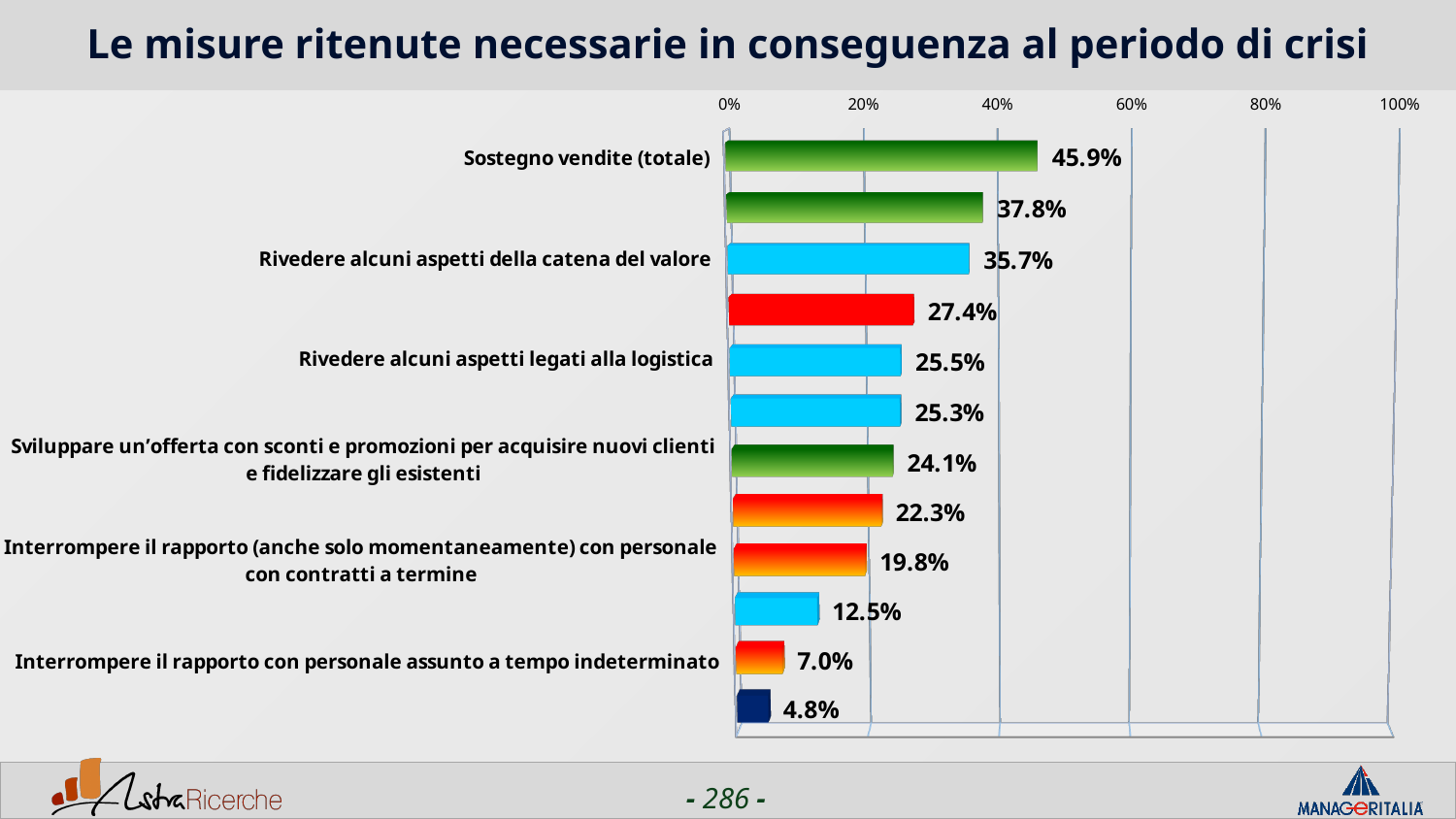
What is the value for "Rivedere alcuni aspetti della catena del valore"? 35.7% What is the value for "Rivedere alcuni aspetti legati alla logistica"? 25.5% What is the difference between the values for "Sostegno vendite (totale)" and "Rivedere alcuni aspetti della catena del valore"? 10.2 percentage points What is the title of the slide? Le misure ritenute necessarie in conseguenza al periodo di crisi How many bars are plotted in the chart? 12 What type of chart is shown on the slide? bar chart What is the smallest value shown in the chart? 4.8% Which is larger: the value for "Rivedere alcuni aspetti legati alla logistica" or the value for "Interrompere il rapporto con personale assunto a tempo indeterminato"? Rivedere alcuni aspetti legati alla logistica What is the value for "Interrompere il rapporto (anche solo momentaneamente) con personale con contratti a termine"? 19.8% What is the value for "Interrompere il rapporto con personale assunto a tempo indeterminato"? 7.0% What is the value for "Sostegno vendite (totale)"? 45.9% Which category has the highest value in the chart? Sostegno vendite (totale)